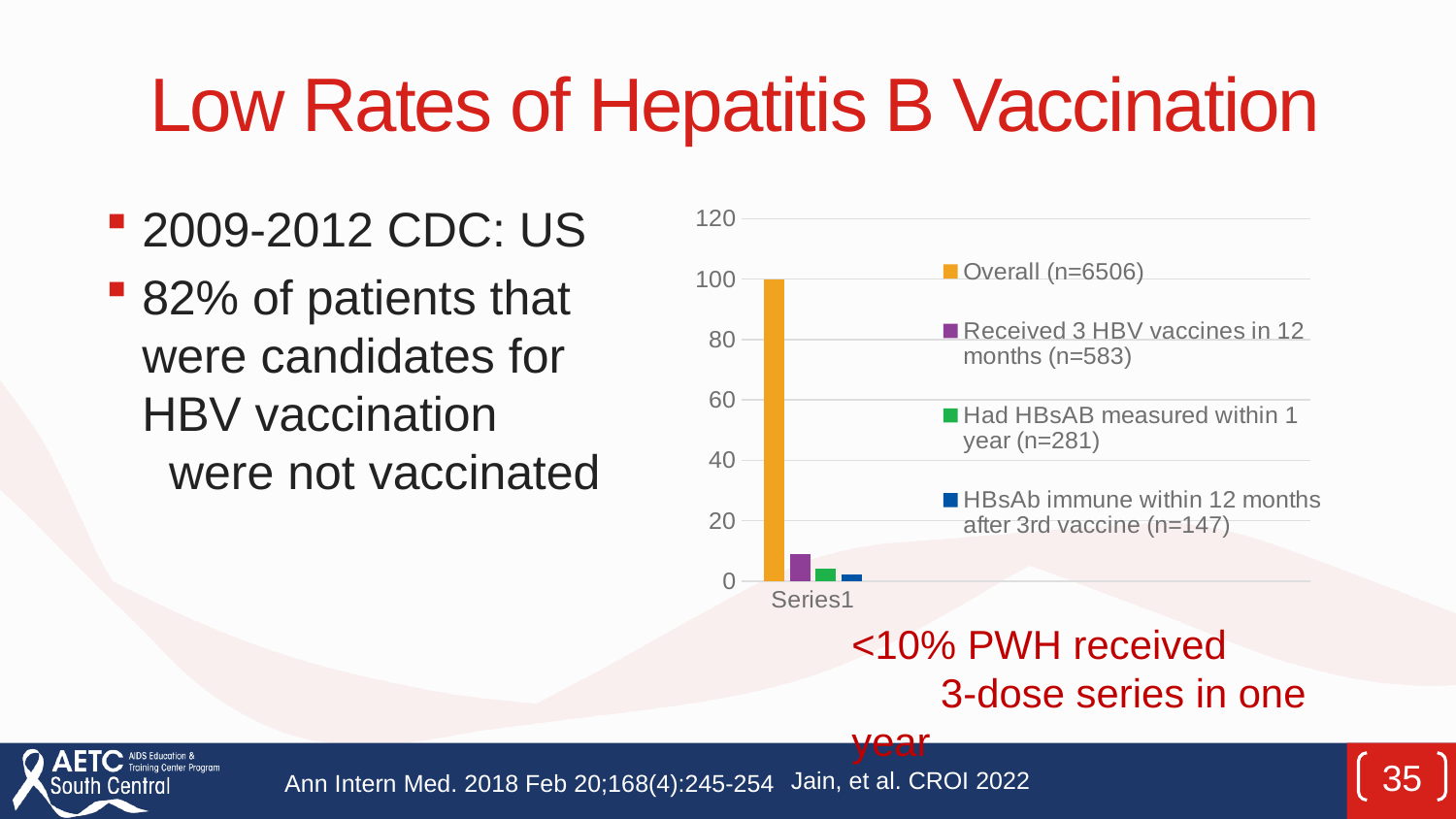
Which is larger, the bar for Overall (n=6506) or the bar for Received 3 HBV vaccines in 12 months (n=583)? Overall (n=6506) Which series has the highest bar in the chart? Overall (n=6506) How many categories are shown on the x axis of the chart? 1 What is the label of the single category on the x axis of the chart? Series1 Is the value for Overall (n=6506) greater or less than 80? greater What kind of chart is shown on the slide? bar chart What is the highest value shown on the chart's vertical axis? 120 Is the value for Received 3 HBV vaccines in 12 months (n=583) greater or less than 20? less What value does the Overall (n=6506) bar reach on the chart? 100 Is the value for Had HBsAB measured within 1 year (n=281) greater or less than 20? less How many series does the chart legend list? 4 Which is larger, the bar for Received 3 HBV vaccines in 12 months (n=583) or the bar for HBsAb immune within 12 months after 3rd vaccine (n=147)? Received 3 HBV vaccines in 12 months (n=583)